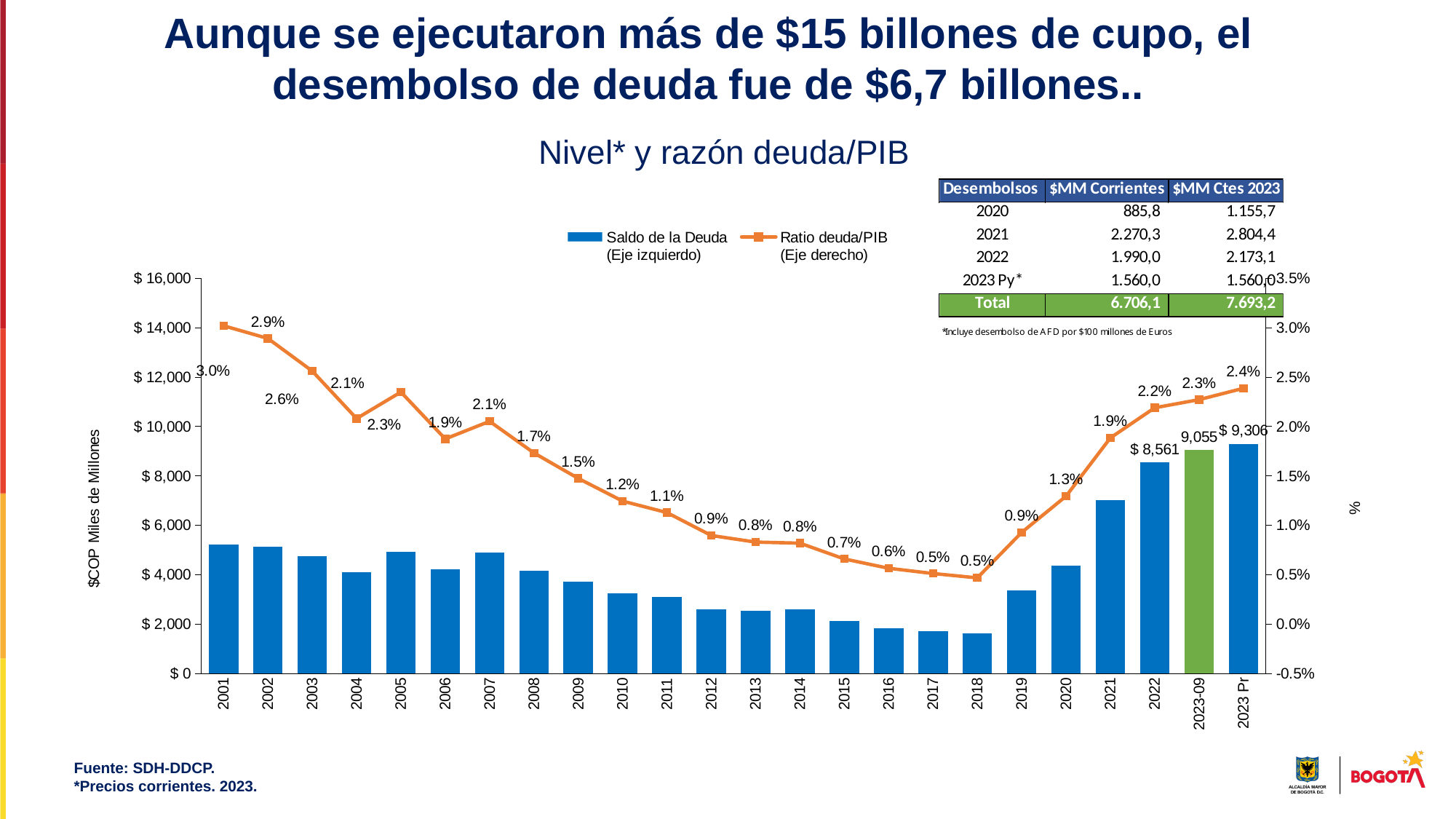
What is the difference between the Saldo de la Deuda for 2023 Pr and for 2022? 745 Which is larger, the Saldo de la Deuda bar for 2023-09 or for 2023 Pr? 2023 Pr In which year is the Ratio deuda/PIB highest? 2001 What is the lowest Ratio deuda/PIB value shown on the line? 0.5% What is the Ratio deuda/PIB value for 2020? 1.3% Is the Saldo de la Deuda value for 2018 greater or less than $ 2,000? less What is the Ratio deuda/PIB value for 2023 Pr? 2.4% What is the Saldo de la Deuda value labelled for 2022? $ 8,561 What is the Ratio deuda/PIB value for 2001? 3.0% What kind of chart is shown? Combined bar and line chart How many series does the chart legend list? 2 Does the Ratio deuda/PIB rise or fall from 2001 to 2018? Fall